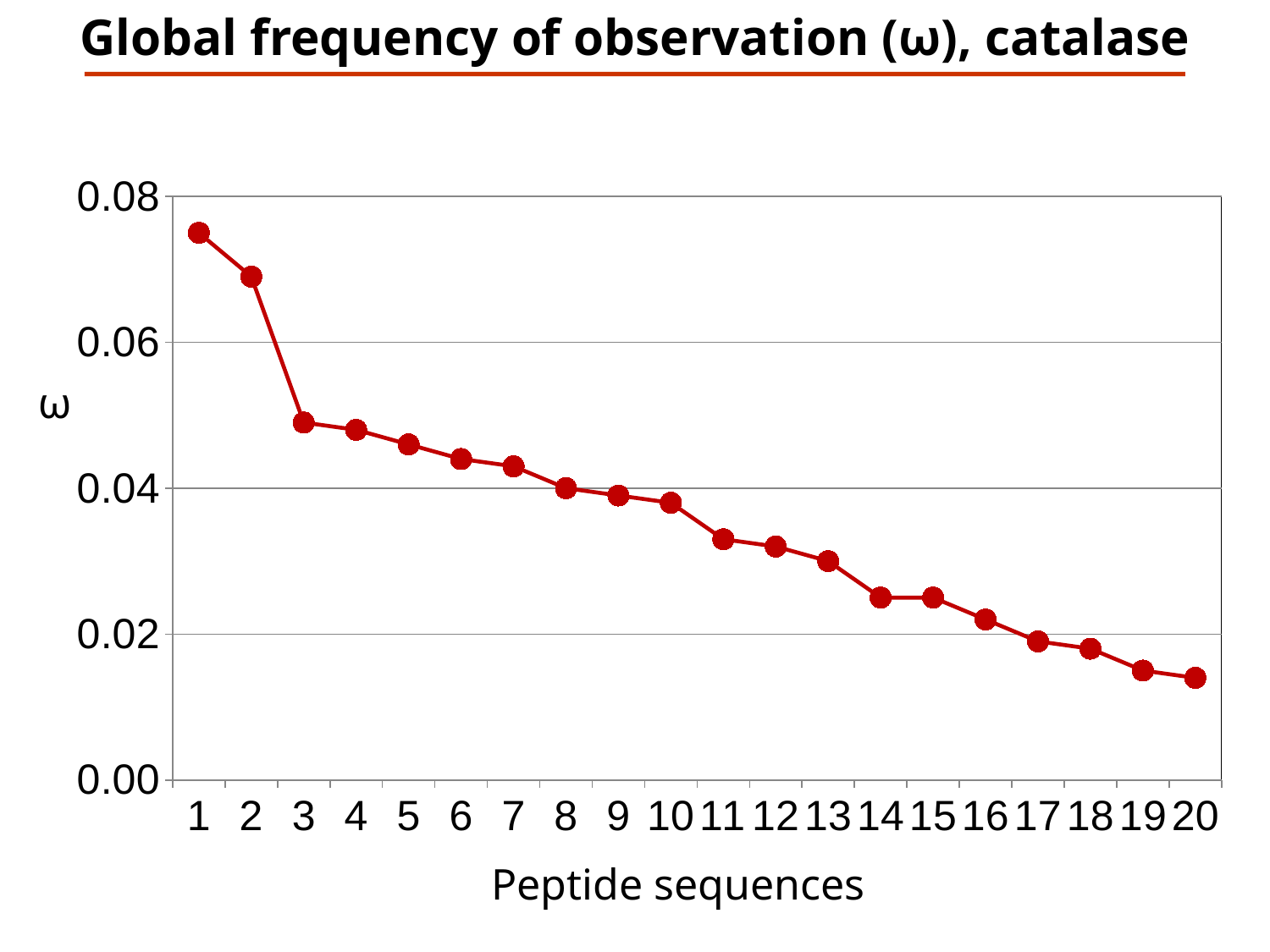
What is the title of the chart? Global frequency of observation (ω), catalase Is the value of ω for peptide sequence 1 greater or less than 0.06? greater Is the value of ω for peptide sequence 11 greater or less than 0.04? less Which peptide sequence has the lowest value of ω? 20 Which peptide sequence has the highest value of ω? 1 Is the value of ω for peptide sequence 3 greater or less than 0.06? less How many peptide sequences are plotted on the x axis? 20 Which has a larger value of ω, peptide sequence 2 or peptide sequence 3? peptide sequence 2 What kind of chart is shown on the slide? line chart Do the values of ω rise or fall as the peptide sequence number increases from 1 to 20? fall